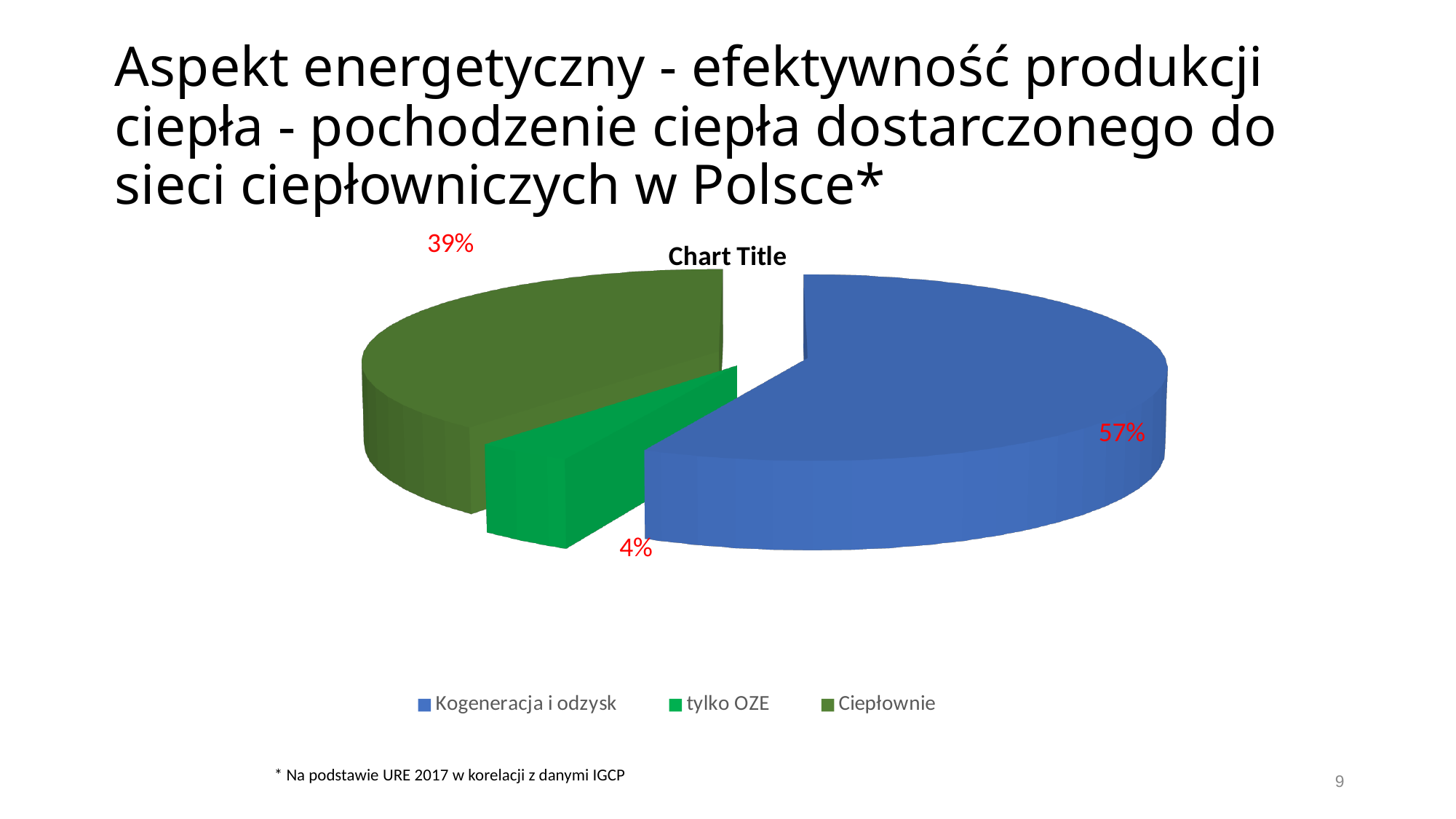
Which category has the largest share of the pie? Kogeneracja i odzysk What is the title shown on the chart? Chart Title What is the difference in percentage points between Kogeneracja i odzysk and Ciepłownie? 18 How many categories does the pie chart show? 3 Which is larger, the share for Ciepłownie or the share for tylko OZE? Ciepłownie What share of the pie does Kogeneracja i odzysk have? 57% What is the difference in percentage points between Ciepłownie and tylko OZE? 35 What kind of chart is shown on the slide? Pie chart What share of the pie does Ciepłownie have? 39% Which colour represents tylko OZE in the legend? Green What share of the pie does tylko OZE have? 4% Which category has the smallest share of the pie? tylko OZE